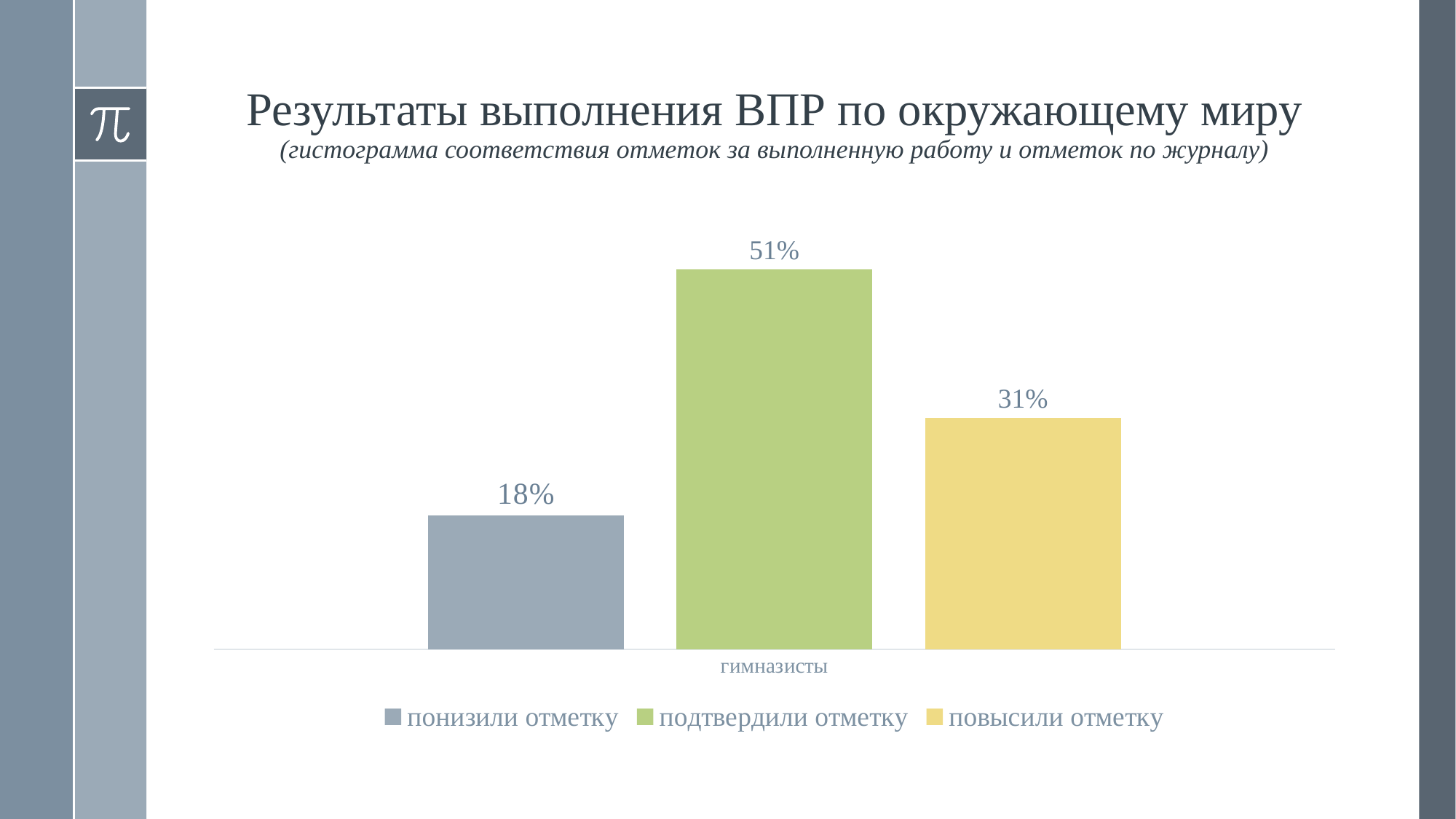
What is the value for "понизили отметку"? 18% What is the category label shown on the x axis? гимназисты What is the value for "повысили отметку"? 31% How many series does the legend list? 3 What colour is the bar for "повысили отметку"? yellow What is the difference between the values for "подтвердили отметку" and "повысили отметку"? 20% What is the value for "подтвердили отметку"? 51% What is the difference between the values for "повысили отметку" and "понизили отметку"? 13% Which is larger: the value for "повысили отметку" or the value for "понизили отметку"? повысили отметку Which series has the highest value? подтвердили отметку Which series has the lowest value? понизили отметку What kind of chart is shown on the slide? bar chart